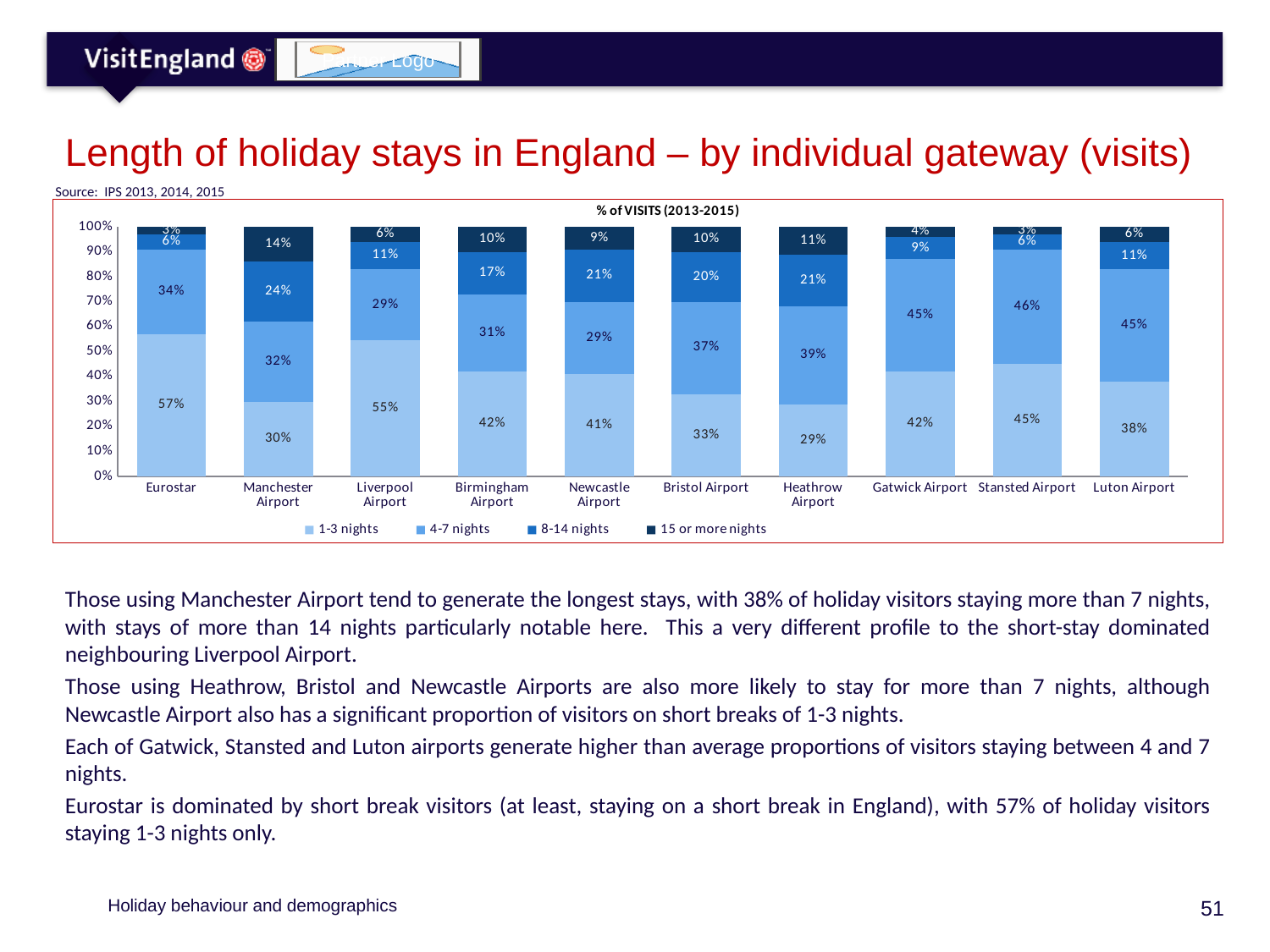
Which gateway has the highest share of 1-3 night holiday visits? Eurostar How many percentage points higher is the 1-3 nights share for Eurostar than for Manchester Airport? 27 percentage points Which gateway has the highest share of 15 or more nights holiday visits? Manchester Airport What type of chart is used to show the length of holiday stays by gateway? Stacked bar chart What percentage of holiday visits via Eurostar were 1-3 nights? 57% How many series does the chart legend list? 4 Which gateway has the lowest share of 1-3 night holiday visits? Heathrow Airport Which has a larger 4-7 nights share: Stansted Airport or Liverpool Airport? Stansted Airport What share of holiday visits via Manchester Airport were 15 or more nights? 14% What percentage of holiday visits via Heathrow Airport were 4-7 nights? 39% What percentage of holiday visits via Newcastle Airport were 8-14 nights? 21% How many gateways are shown on the x axis of the chart? 10